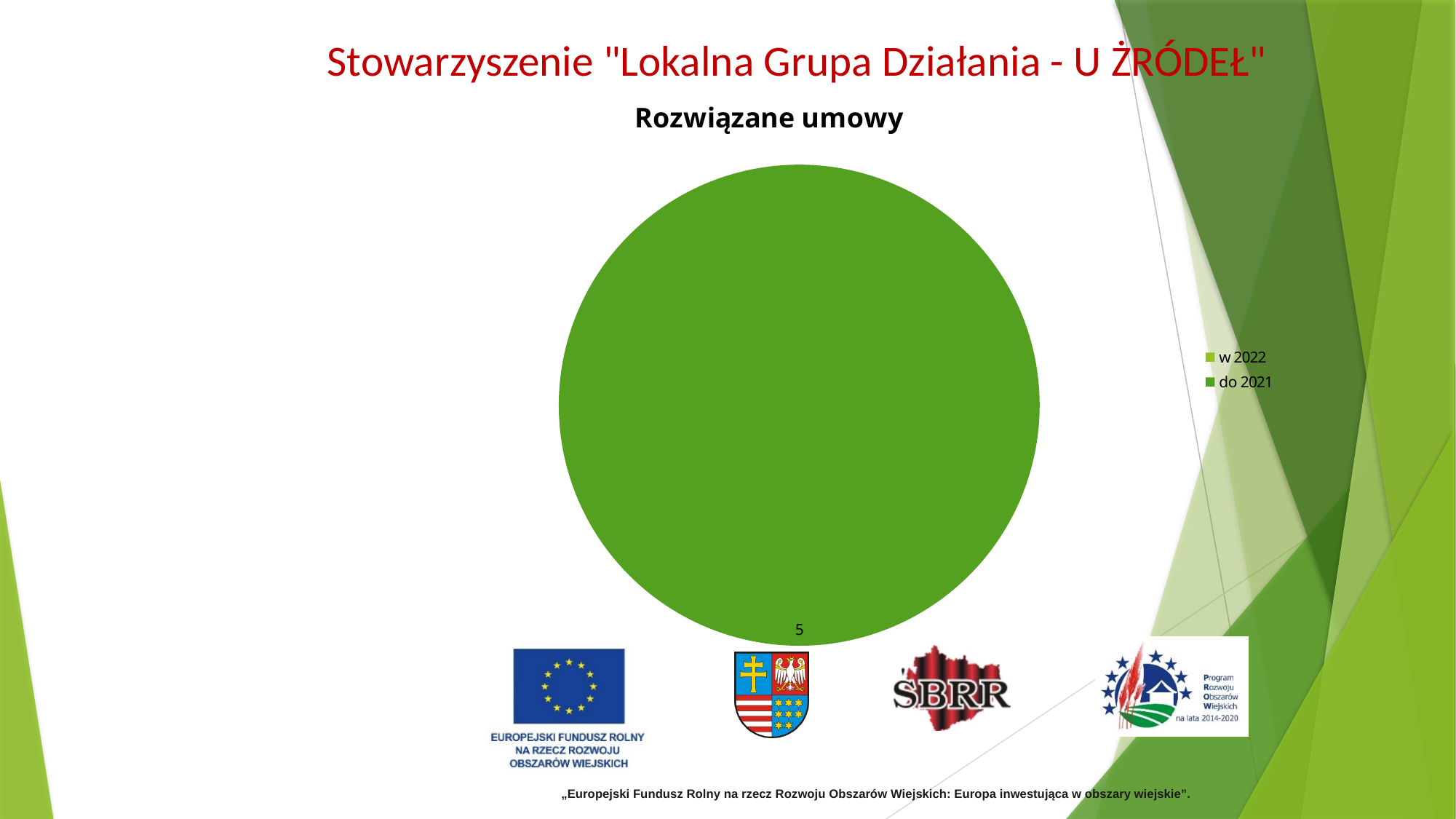
What share of the pie does the "do 2021" slice take up? 100% Which legend category does the visible pie slice belong to? do 2021 How many entries does the chart legend list? 2 What are the two categories listed in the legend? w 2022 and do 2021 Which of the two legend categories, "w 2022" or "do 2021", has the larger slice? do 2021 What kind of chart is shown on the slide? pie chart What value is printed on the pie slice for "do 2021"? 5 What is the title of the chart? Rozwiązane umowy Which category has the largest slice of the pie? do 2021